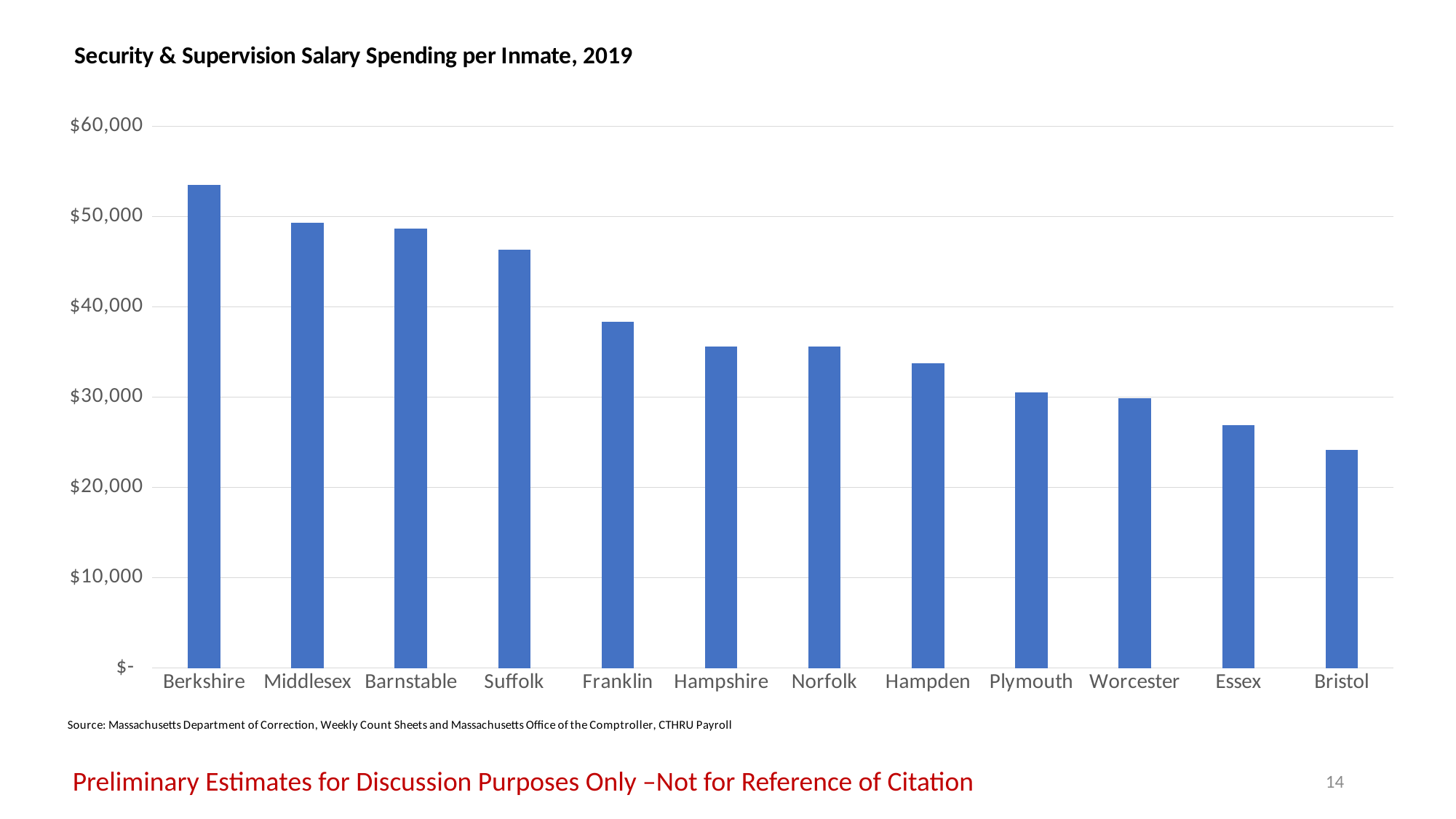
What kind of chart is shown on the slide? bar chart Is the value for Berkshire greater or less than $50,000? greater What is the title of the chart? Security & Supervision Salary Spending per Inmate, 2019 Which county has the highest security & supervision salary spending per inmate? Berkshire Is the value for Bristol greater or less than $20,000? greater Which is larger, the value for Suffolk or the value for Franklin? Suffolk Do the values rise or fall moving from left to right along the x axis? fall Is the value for Suffolk greater or less than $50,000? less How many counties are shown on the x axis? 12 Which county has the lowest security & supervision salary spending per inmate? Bristol